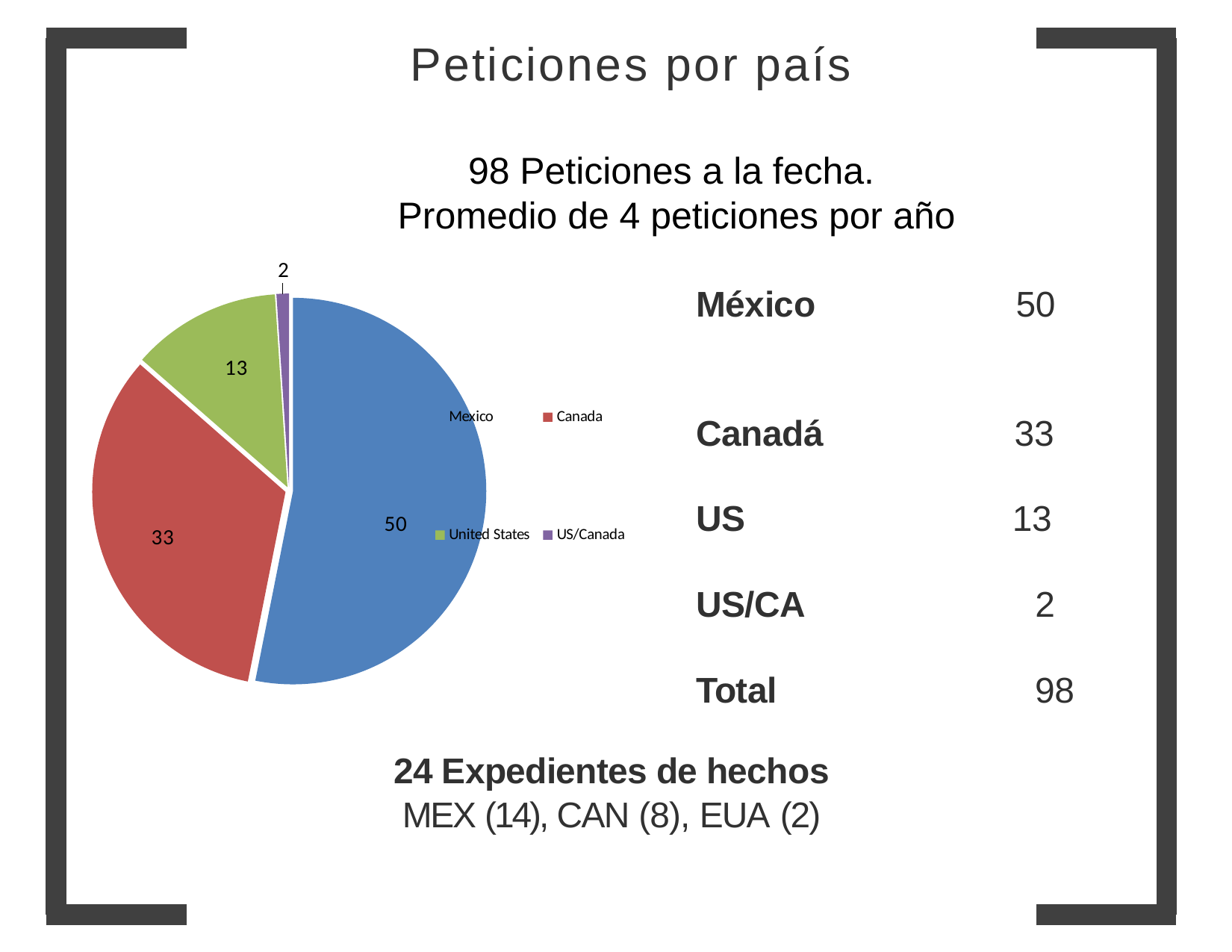
Which category has the largest slice in the pie chart? Mexico What is the value for US/Canada in the pie chart? 2 Which is larger, the value for Canada or the value for United States? Canada What is the value for Mexico in the pie chart? 50 What is the value for Canada in the pie chart? 33 What type of chart is shown on the slide? pie chart What is the total of all slices in the pie chart? 98 What is the value for United States in the pie chart? 13 How many slices does the pie chart have? 4 How many entries does the legend list? 4 What is the difference between the values for Mexico and Canada? 17 Which category has the smallest slice in the pie chart? US/Canada